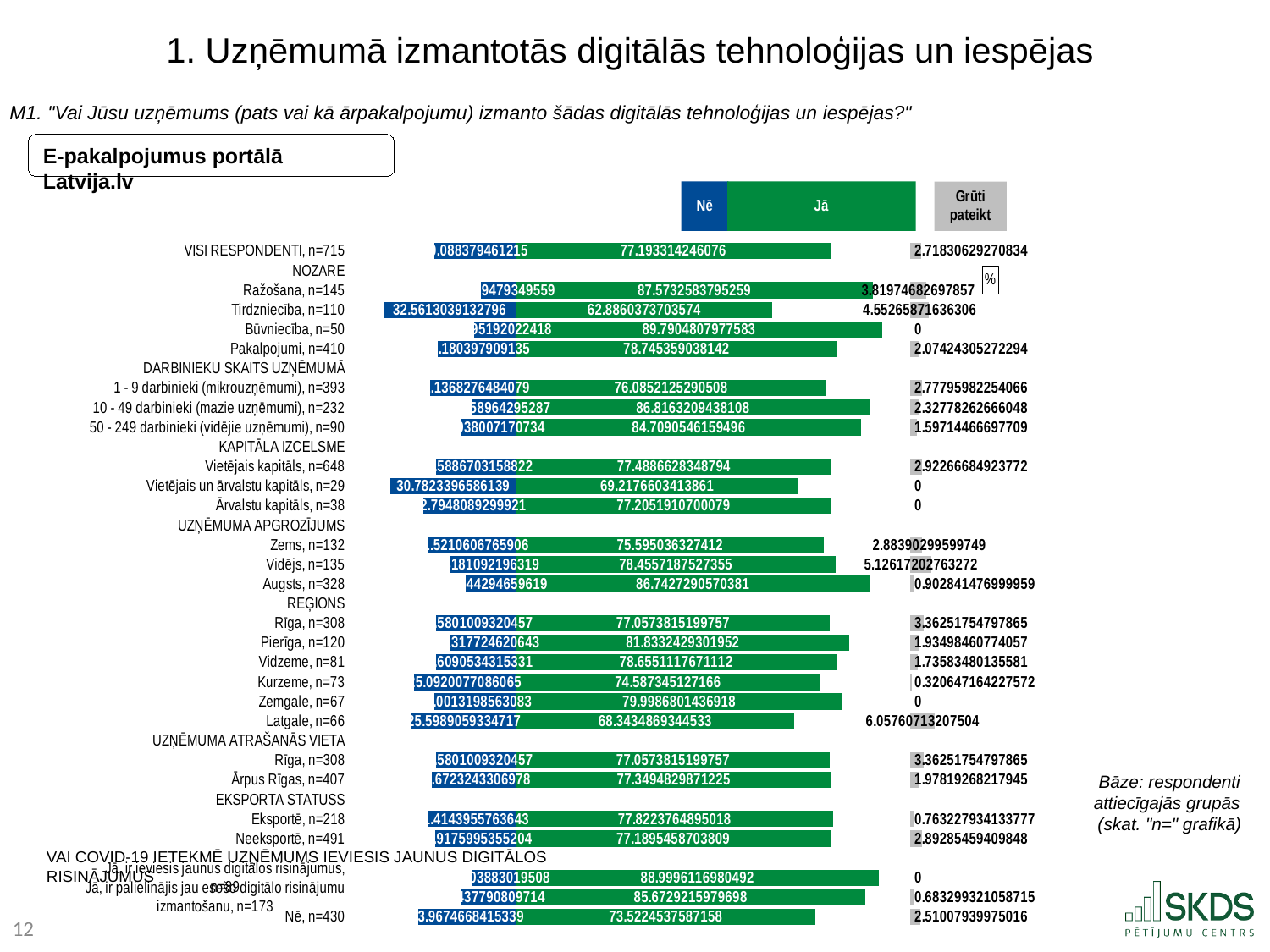
Among the NOZARE groups, which has the lowest "Jā" value? Tirdzniecība, n=110 What is the "Jā" value for "Vietējais un ārvalstu kapitāls, n=29"? 69.2176603413861 What is the difference between the "Grūti pateikt" values for "Latgale, n=66" and "Rīga, n=308" under REĢIONS? 2.69508958409639 What is the "Grūti pateikt" value for "Latgale, n=66"? 6.05760713207504 Which has a larger "Jā" value: "Ražošana, n=145" or "Tirdzniecība, n=110"? Ražošana, n=145 What is the "Nē" value for "Tirdzniecība, n=110"? 32.5613039132796 How many regions are listed under the REĢIONS group? 6 Among the NOZARE groups, which has the highest "Jā" value? Būvniecība, n=50 What is the "Jā" value for "VISI RESPONDENTI, n=715"? 77.193314246076 Which colour represents the "Jā" series in the legend? Green How many series does the legend list? 3 What kind of chart is shown on the slide? Stacked bar chart